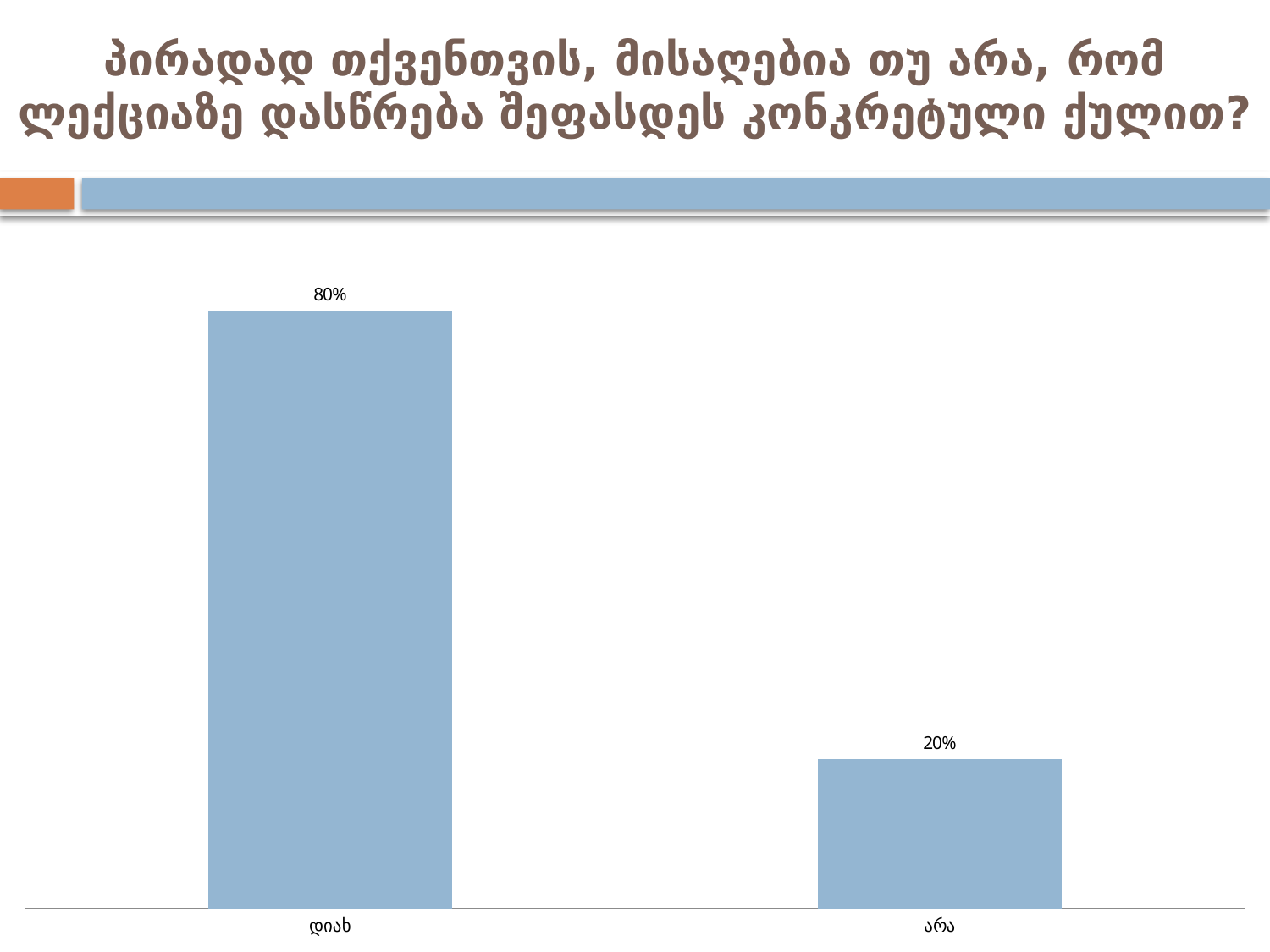
What is the value for დიახ? 80% What colour are the bars in the chart? light blue What is the difference between the values for დიახ and არა? 60% What is the total of the two values shown in the chart? 100% What is the value for არა? 20% Which category has the highest value? დიახ Which is larger, the value for დიახ or the value for არა? დიახ What kind of chart is shown on the slide? bar chart How many categories are shown in the chart? 2 What are the category labels on the x axis of the chart? დიახ, არა Which category has the lowest value? არა